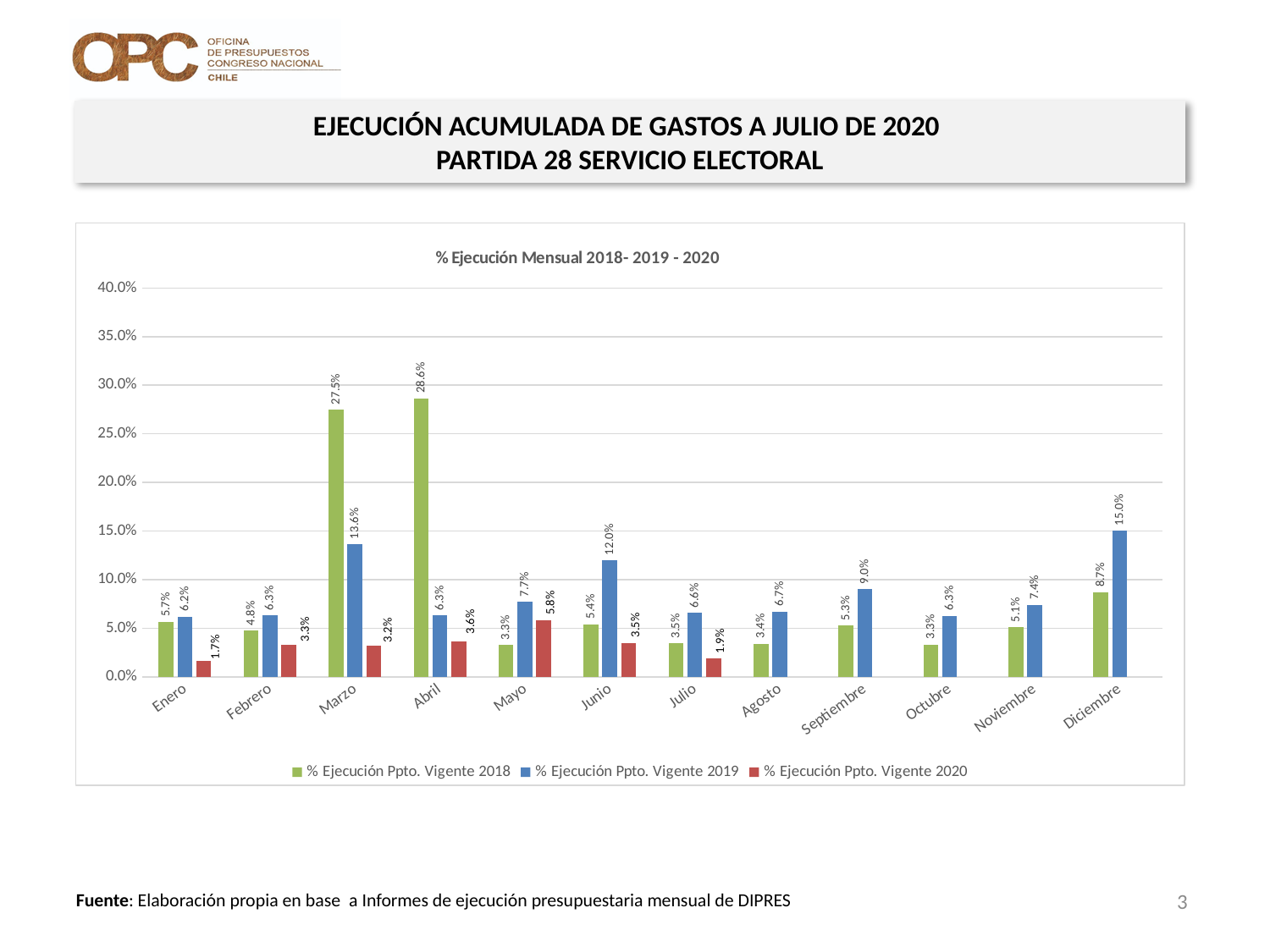
How many months are shown on the x axis? 12 Which is larger in Junio: the 2018 value or the 2019 value? 2019 value What kind of chart is shown on the slide? Bar chart What is the value for % Ejecución Ppto. Vigente 2020 in Mayo? 5.8% In which month is the % Ejecución Ppto. Vigente 2020 series lowest? Enero Is the value for % Ejecución Ppto. Vigente 2018 in Abril greater or less than 25.0%? greater What is the value for % Ejecución Ppto. Vigente 2019 in Diciembre? 15.0% What is the difference between the 2018 and 2019 values in Marzo? 13.9% What is the title of the chart? % Ejecución Mensual 2018- 2019 - 2020 What is the value for % Ejecución Ppto. Vigente 2018 in Marzo? 27.5% How many series does the legend list? 3 In which month is the % Ejecución Ppto. Vigente 2018 series highest? Abril